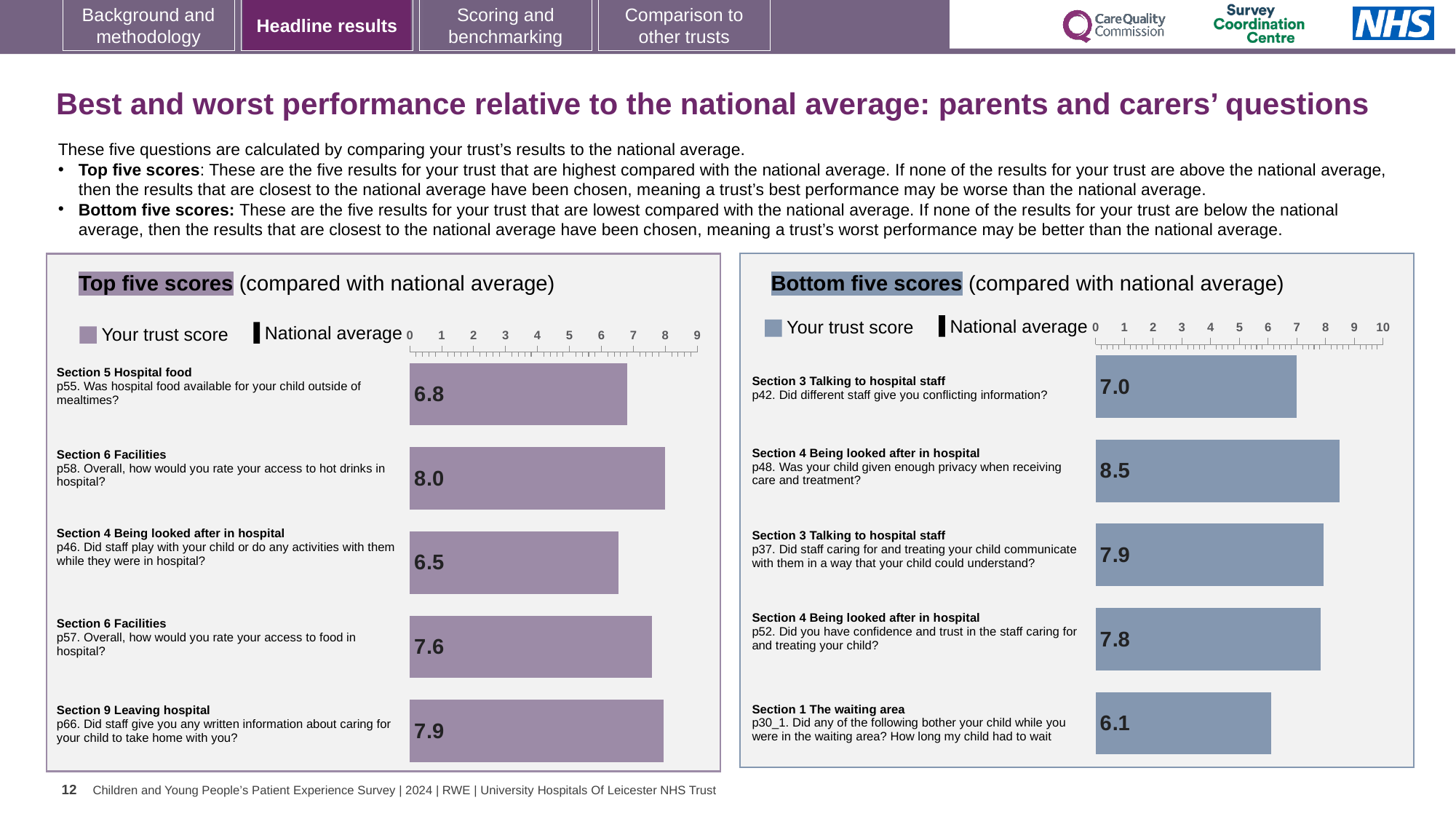
In the Bottom five scores chart, which has the larger trust score: p42 or p52? p52 In the Bottom five scores chart, what is the difference between the trust scores for p37 and p30_1? 1.8 In the Top five scores chart, which question has the highest trust score? p58. Overall, how would you rate your access to hot drinks in hospital? In the Bottom five scores chart, which question has the highest trust score? p48. Was your child given enough privacy when receiving care and treatment? In the Top five scores chart, what is the difference between the trust scores for p58 and p46? 1.5 In the Top five scores chart, how many questions are shown? 5 In the Top five scores chart, what is the trust score for p55 (Was hospital food available for your child outside of mealtimes?)? 6.8 In the Bottom five scores chart, what is the trust score for p48 (Was your child given enough privacy when receiving care and treatment?)? 8.5 In the Bottom five scores chart, which question has the lowest trust score? p30_1. Did any of the following bother your child while you were in the waiting area? How long my child had to wait What type of chart is used in the Top five scores panel? Bar chart In the Bottom five scores chart, what is the maximum value shown on the axis? 10 In the Top five scores chart, which question has the lowest trust score? p46. Did staff play with your child or do any activities with them while they were in hospital?